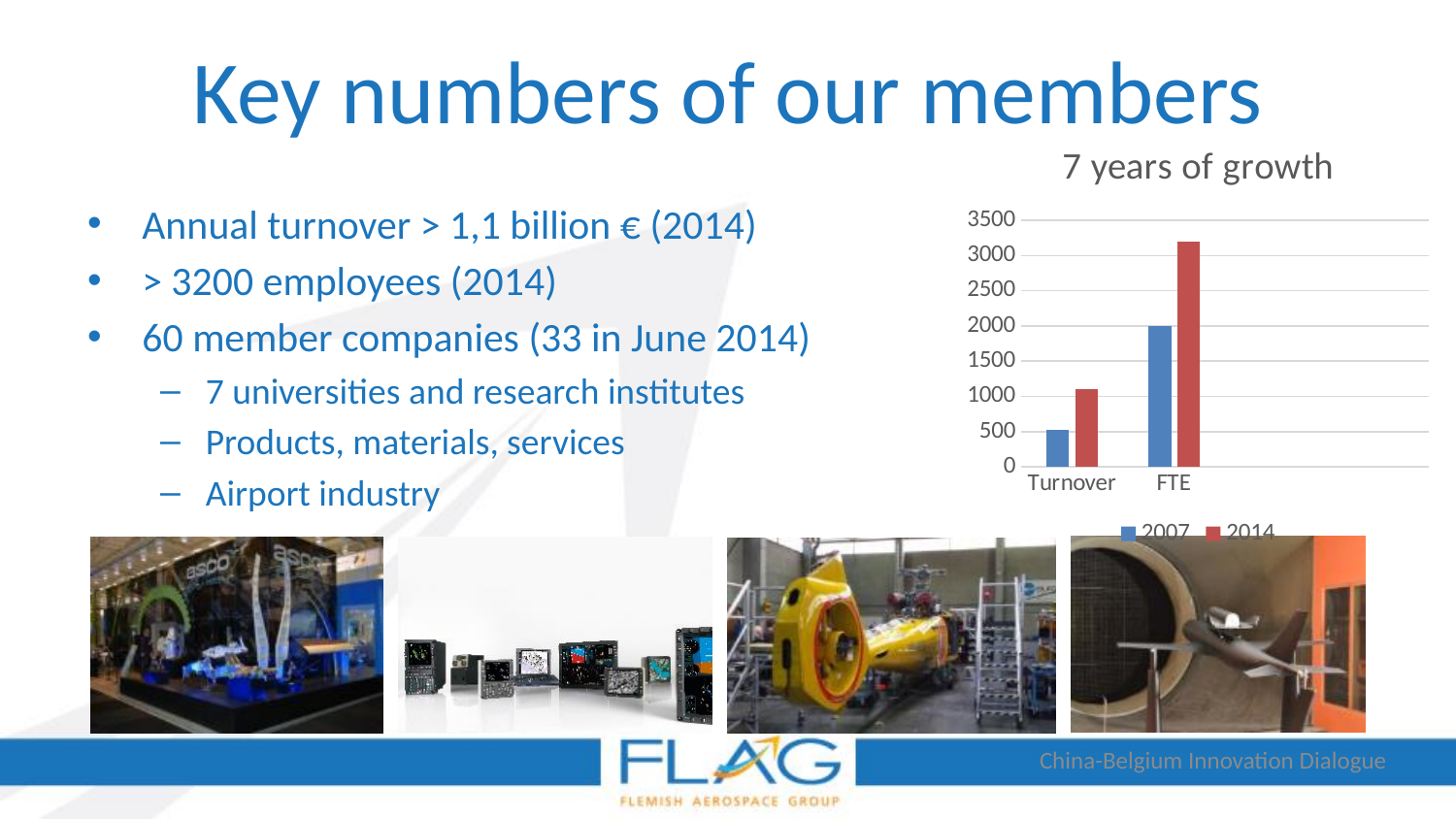
How many categories are shown on the x axis of the "7 years of growth" chart? 2 In the "7 years of growth" chart, is the 2007 value for FTE greater or less than 1500? greater What kind of chart is shown under the heading "7 years of growth"? bar chart In the "7 years of growth" chart, is the 2007 value for Turnover greater or less than 1000? less In the "7 years of growth" chart, which category has the lowest 2007 value? Turnover Which two years are listed in the legend of the "7 years of growth" chart? 2007 and 2014 How many series does the legend of the "7 years of growth" chart list? 2 In the "7 years of growth" chart, is the 2014 value for FTE greater or less than 3000? greater In the "7 years of growth" chart, which category has the highest 2014 value? FTE What is the title of the chart on the slide? 7 years of growth In the "7 years of growth" chart, which is larger for FTE: the 2007 value or the 2014 value? 2014